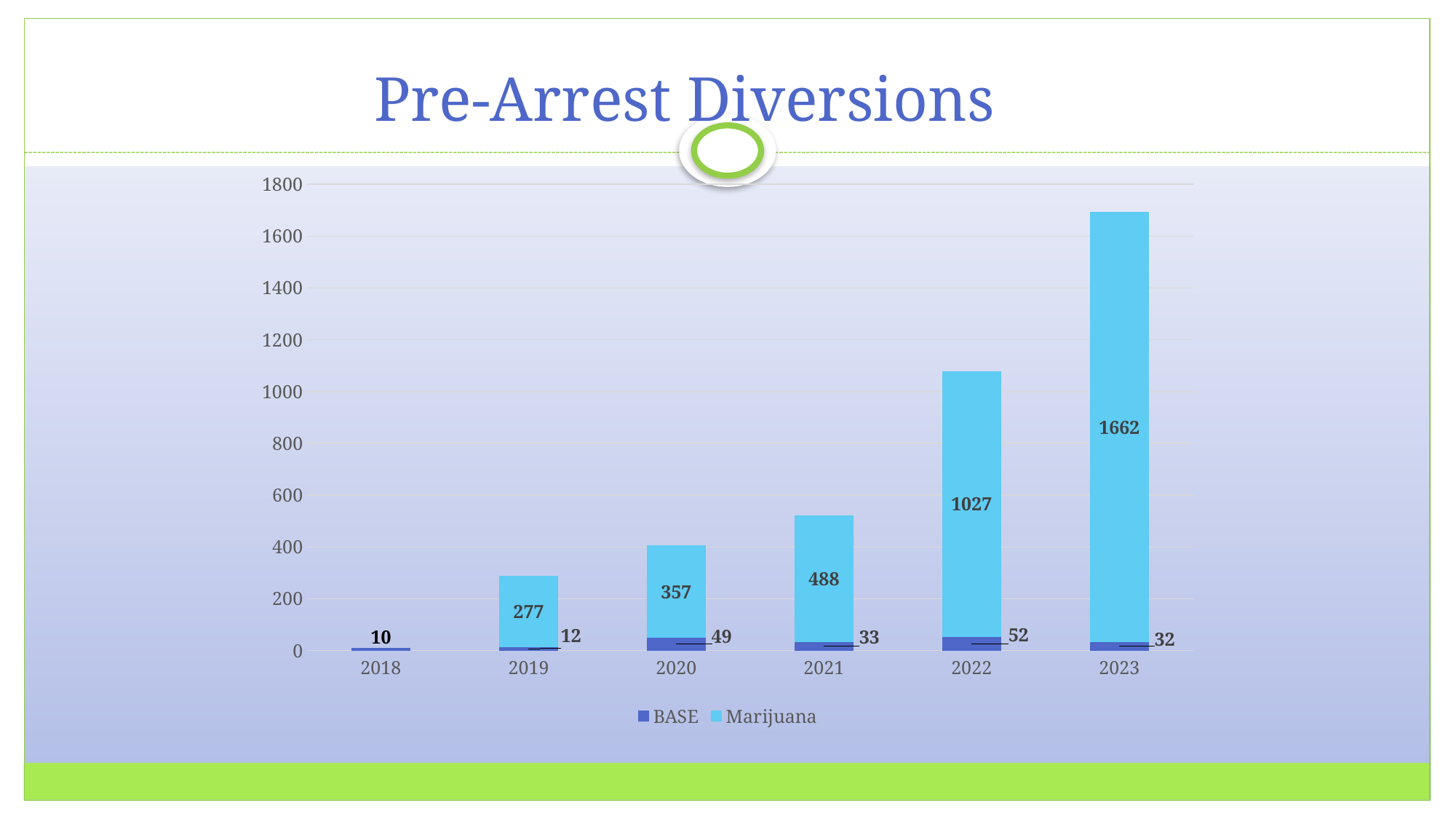
What is the difference between the Marijuana values for 2023 and 2022? 635 Which year has the lowest BASE value? 2018 What is the Marijuana value for 2023? 1662 What is the Marijuana value for 2019? 277 Which year has the highest Marijuana value? 2023 How many series does the legend list? 2 What is the BASE value for 2020? 49 How many years are shown on the x axis? 6 Do the Marijuana values rise or fall from 2019 to 2023? Rise What kind of chart is shown on the slide? Stacked bar chart What is the total of the stacked bar for 2022? 1079 Which is larger, the BASE value for 2022 or the BASE value for 2021? 2022